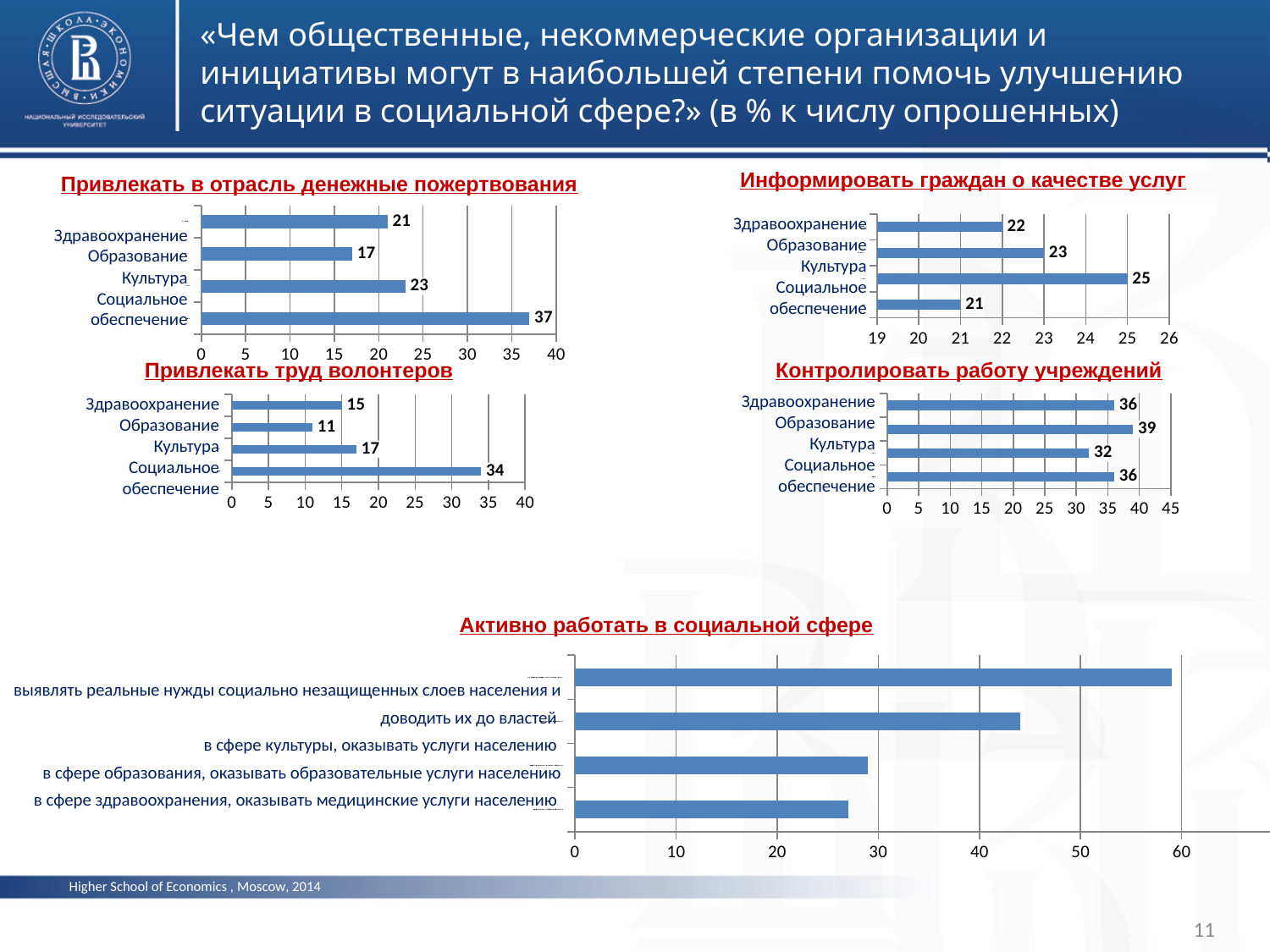
In the chart 'Привлекать в отрасль денежные пожертвования', what is the value for Социальное обеспечение? 37 In the chart 'Контролировать работу учреждений', which is larger: Здравоохранение or Культура? Здравоохранение In the chart 'Информировать граждан о качестве услуг', what is the value for Здравоохранение? 22 In the chart 'Информировать граждан о качестве услуг', which category has the highest value? Культура In the chart 'Контролировать работу учреждений', which category has the highest value? Образование What type of chart is 'Привлекать труд волонтеров'? Bar chart In the chart 'Привлекать в отрасль денежные пожертвования', which category has the lowest value? Образование How many categories are shown in the chart 'Активно работать в социальной сфере'? 4 In the chart 'Привлекать труд волонтеров', what is the difference between Социальное обеспечение and Образование? 23 In the chart 'Привлекать труд волонтеров', what is the value for Культура? 17 In the chart 'Активно работать в социальной сфере', is the value for 'выявлять реальные нужды социально незащищенных слоев населения и доводить их до властей' greater or less than 50? greater In the chart 'Активно работать в социальной сфере', is the value for 'в сфере здравоохранения, оказывать медицинские услуги населению' greater or less than 30? less